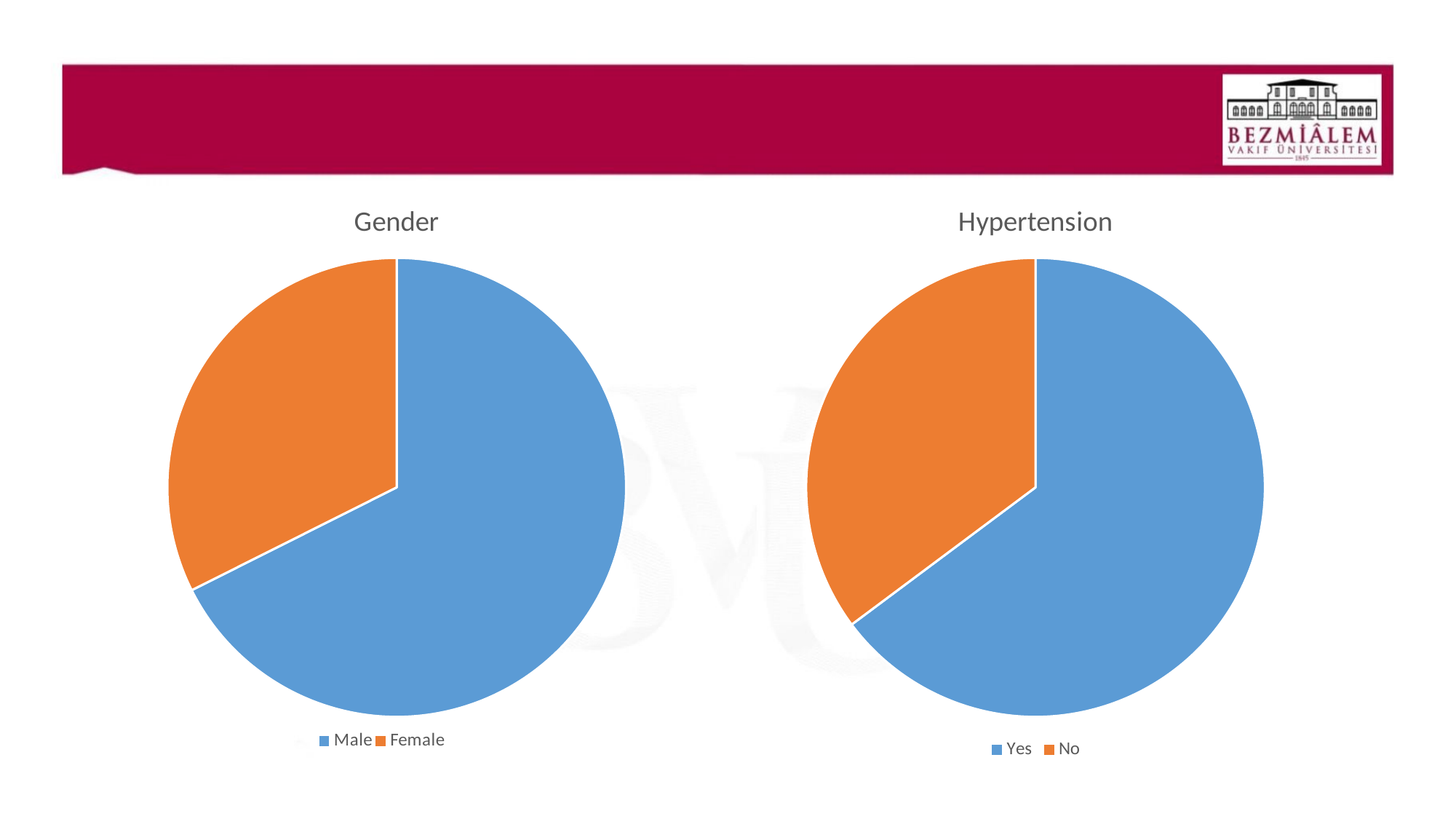
What kind of chart is the "Hypertension" chart? pie chart In the "Hypertension" chart, which category has the smallest slice? No In the "Hypertension" chart, is the No slice larger or smaller than the Yes slice? smaller In the "Hypertension" chart, which category has the largest slice? Yes How many slices does the "Gender" pie chart have? 2 How many entries does the legend of the "Hypertension" chart list? 2 In the "Gender" chart, which category has the smallest slice? Female In the "Hypertension" chart, what colour is the "No" slice? orange In the "Gender" chart, is the Male slice larger or smaller than the Female slice? larger In the "Gender" chart, which category has the largest slice? Male What is the title of the pie chart on the left of the slide? Gender What kind of chart is the "Gender" chart? pie chart